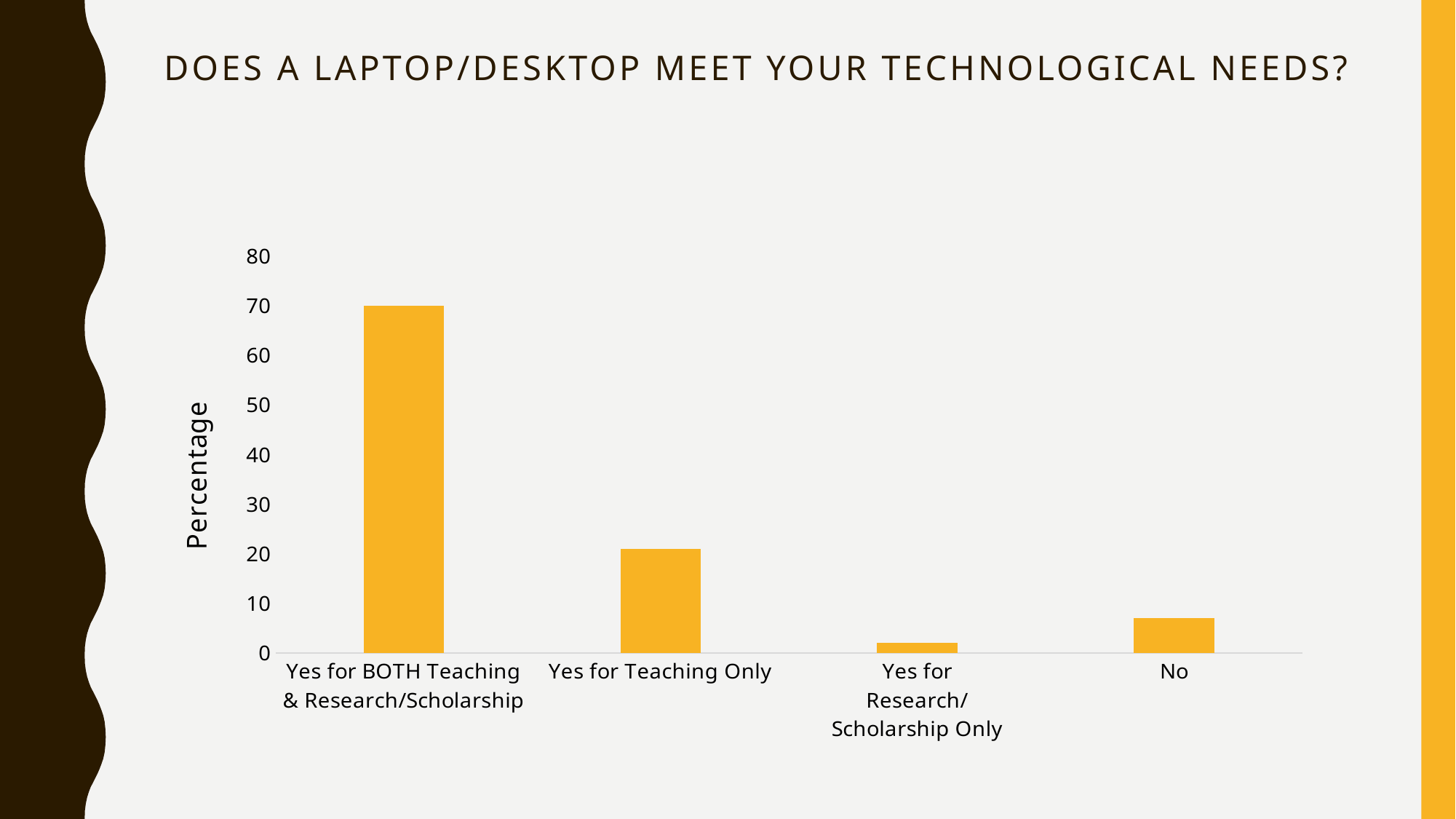
What is the label on the vertical axis of the chart? Percentage Which is larger, the value for "Yes for Teaching Only" or the value for "No"? Yes for Teaching Only Which category has the lowest value in the chart? Yes for Research/Scholarship Only Is the value for "Yes for Teaching Only" greater or less than 30? less What kind of chart is shown on the slide? bar chart What is the title of the slide containing the chart? Does a laptop/desktop meet your technological needs? Is the value for "No" greater or less than 10? less Is the value for "Yes for Teaching Only" greater or less than 10? greater Which is larger, the value for "No" or the value for "Yes for Research/Scholarship Only"? No How many categories are shown on the x axis of the chart? 4 Which category has the highest value in the chart? Yes for BOTH Teaching & Research/Scholarship